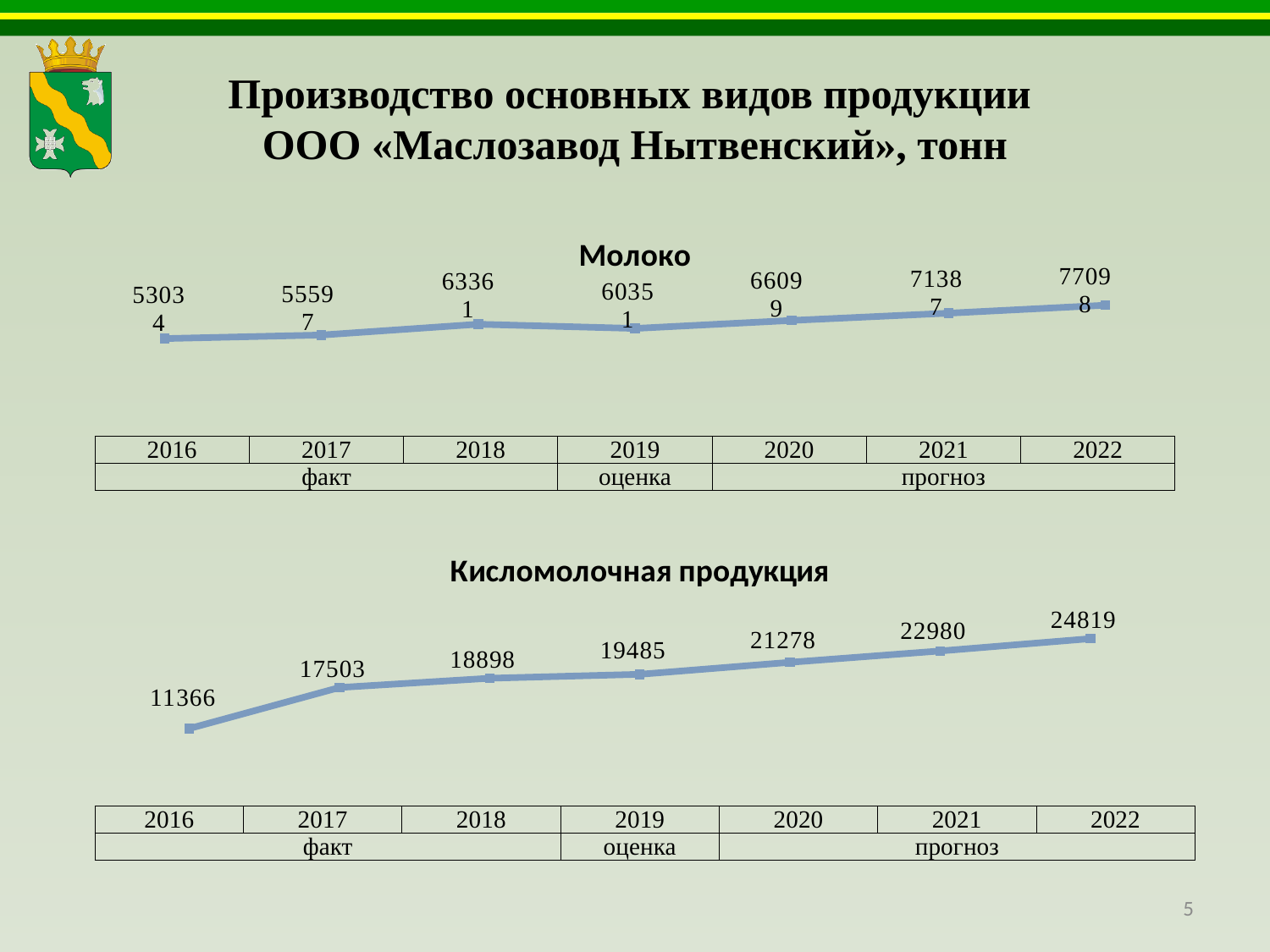
What kind of chart is the 'Молоко' chart? line chart In the 'Кисломолочная продукция' chart, what is the difference between the 2017 and 2016 values? 6137 In the 'Молоко' chart, which year has the larger value, 2018 or 2019? 2018 In the 'Молоко' chart, which year has the highest value? 2022 In the 'Кисломолочная продукция' chart, what is the value for 2016? 11366 In the 'Кисломолочная продукция' chart, what is the value for 2019? 19485 In the 'Кисломолочная продукция' chart, what is the difference between the 2022 and 2016 values? 13453 In the 'Кисломолочная продукция' chart, which year has the lowest value? 2016 How many data points are plotted in the 'Молоко' chart? 7 In the 'Кисломолочная продукция' chart, do the values rise or fall from 2016 to 2022? rise In the 'Кисломолочная продукция' chart, which year has the highest value? 2022 In the 'Кисломолочная продукция' chart, what is the value for 2022? 24819